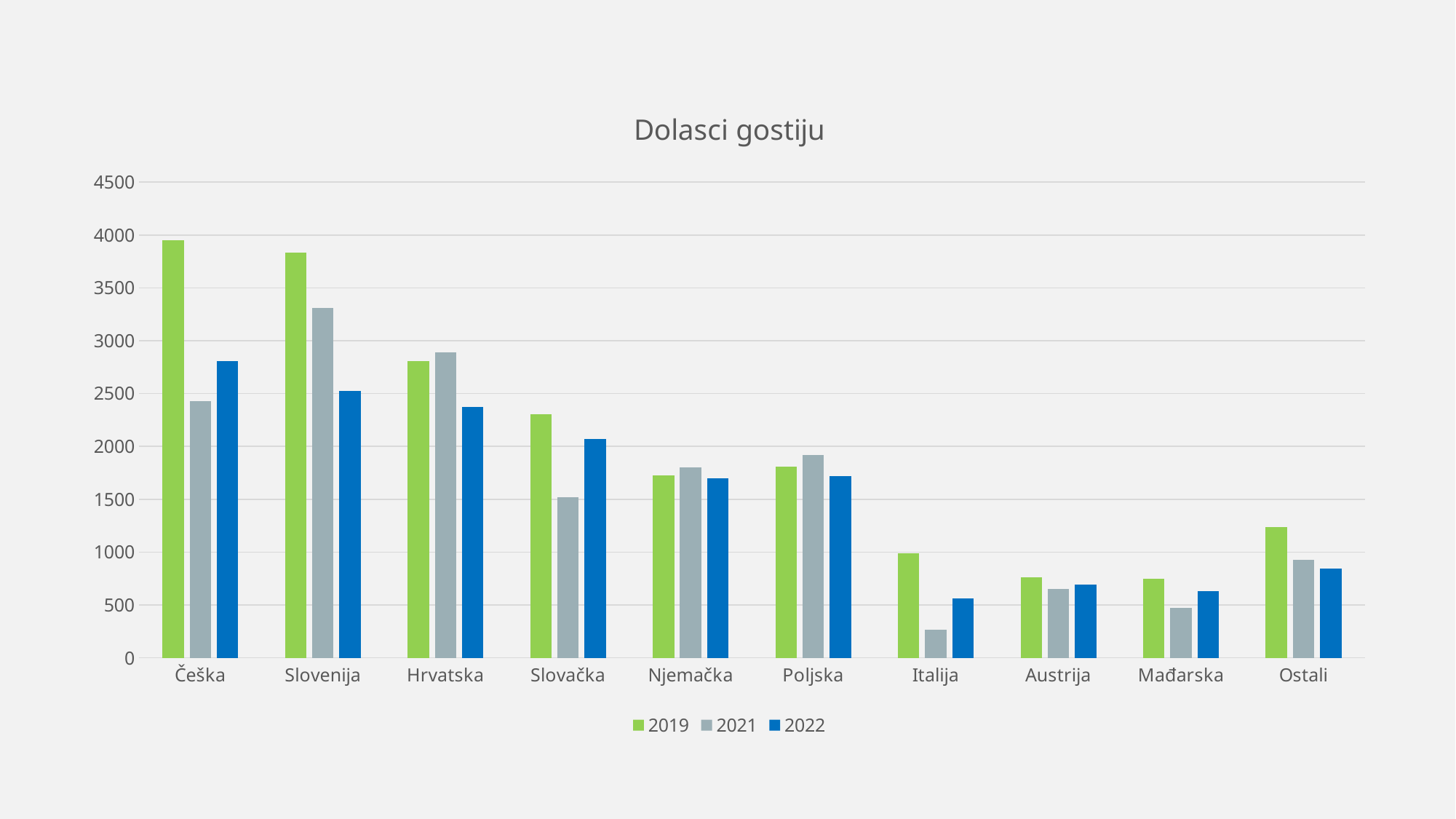
How many categories are shown on the x axis? 10 Which is larger for Slovačka: the 2021 value or the 2022 value? 2022 What kind of chart is shown on the slide? bar chart How many series does the legend list? 3 Which has the larger 2021 value: Češka or Slovenija? Slovenija Is the 2021 value for Slovenija greater or less than 3000? greater Which category has the highest value for the 2022 series? Češka Which category has the lowest value for the 2021 series? Italija Which category has the highest value for the 2019 series? Češka Is the 2019 value for Češka greater or less than 3500? greater Is the 2021 value for Italija greater or less than 500? less What is the title of the chart? Dolasci gostiju